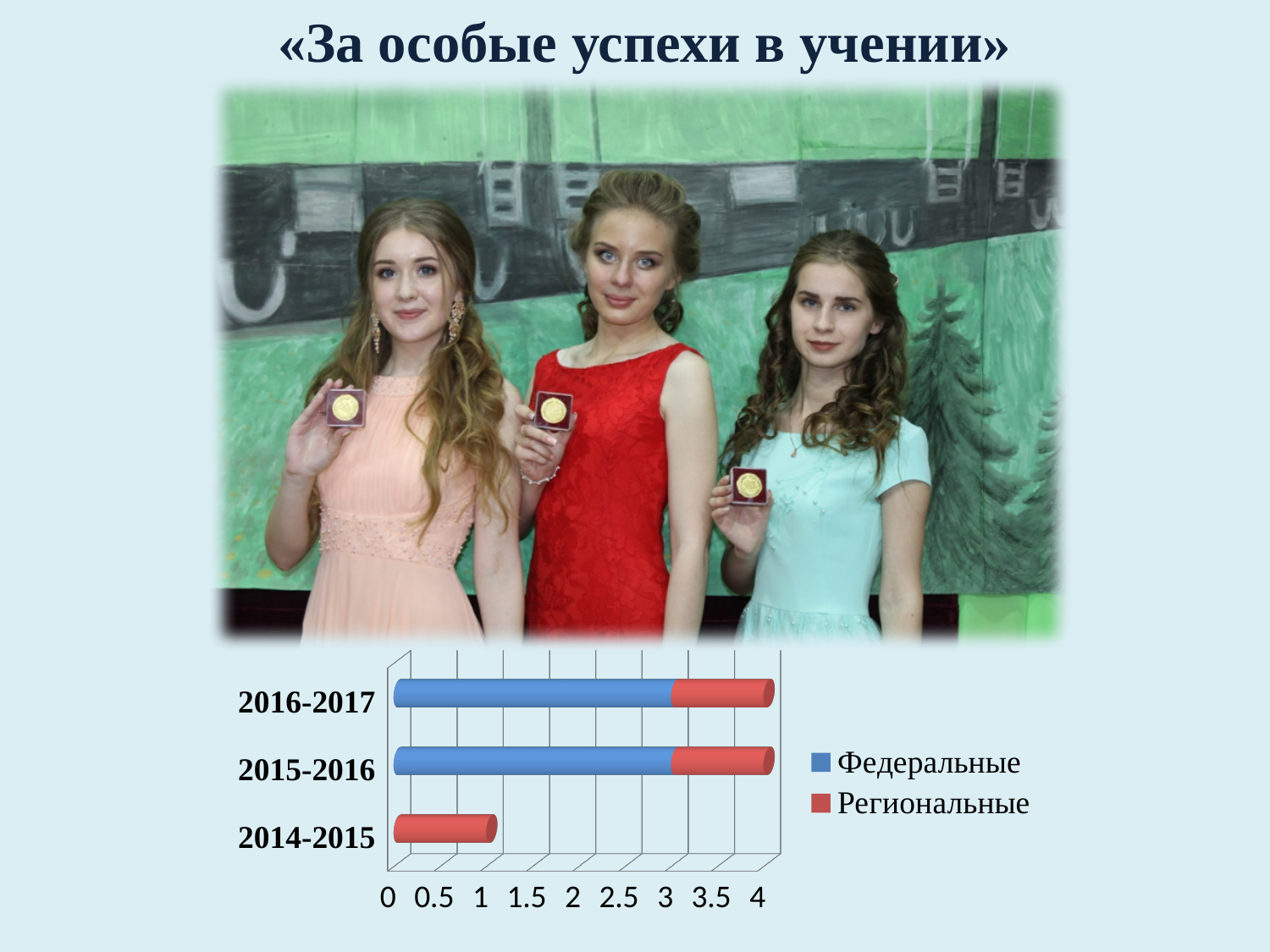
Which school year's bar contains only the Региональные series and no Федеральные segment? 2014-2015 What kind of chart is shown on the slide? bar chart Is the total bar length for 2016-2017 greater or less than 3? greater For 2016-2017, which series has the larger value, Федеральные or Региональные? Федеральные How many series does the chart's legend list? 2 What are the two series named in the chart's legend? Федеральные, Региональные Is the Федеральные value for 2015-2016 greater or less than 2? greater Which colour represents the Федеральные series in the chart? blue Which has the longer total bar, 2014-2015 or 2016-2017? 2016-2017 How many categories (school years) are shown on the chart's vertical axis? 3 Which school year has the lowest total bar length on the chart? 2014-2015 Is the total bar length for 2014-2015 greater or less than 2? less